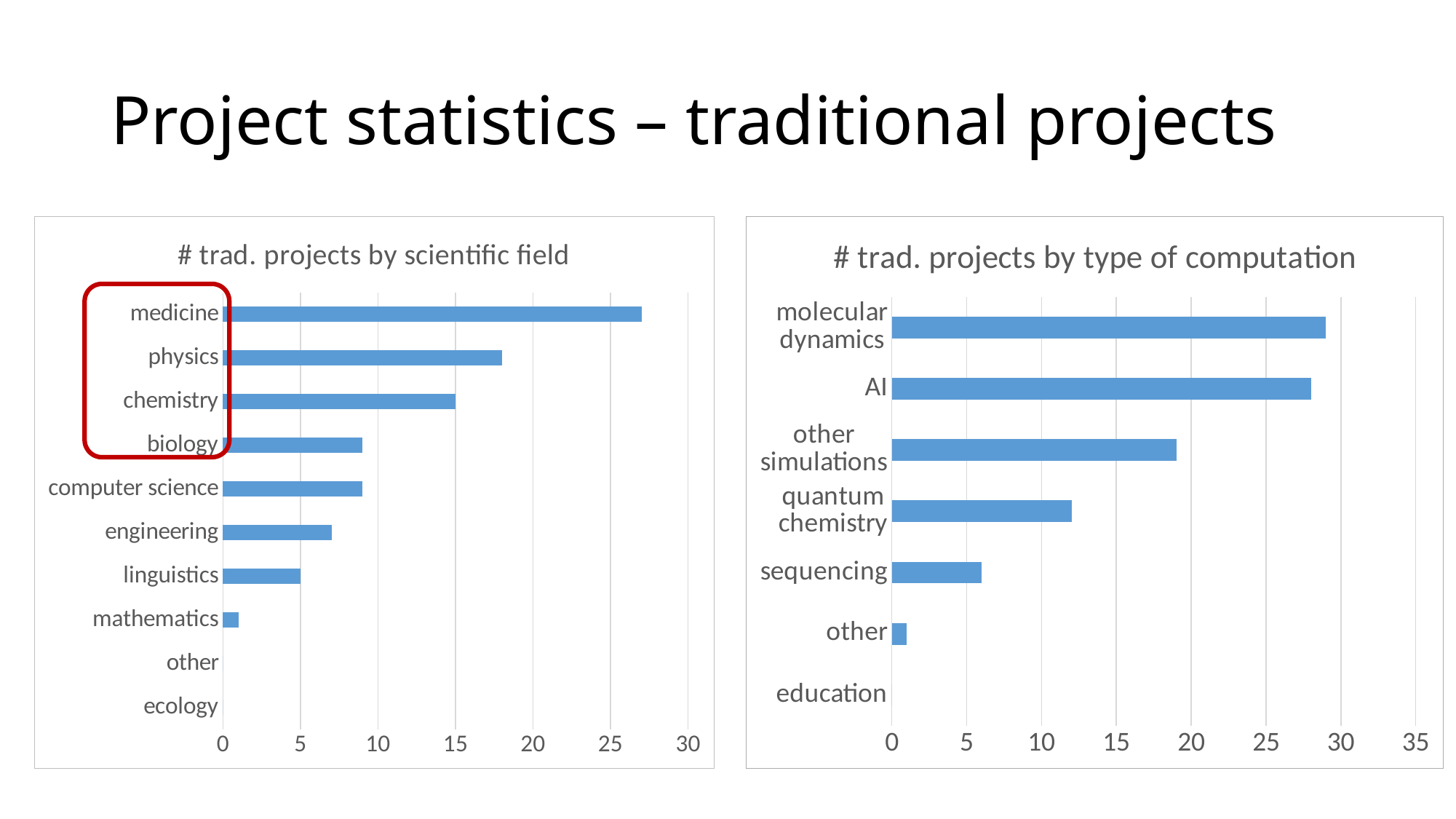
In the '# trad. projects by scientific field' chart, which is larger, physics or chemistry? physics In the '# trad. projects by scientific field' chart, what is the value for chemistry? 15 In the '# trad. projects by scientific field' chart, what is the value for linguistics? 5 In the '# trad. projects by scientific field' chart, is the value for biology greater or less than 10? less In the '# trad. projects by type of computation' chart, is the value for molecular dynamics greater or less than 25? greater How many types of computation are listed in the '# trad. projects by type of computation' chart? 7 What kind of chart is '# trad. projects by scientific field'? bar chart In the '# trad. projects by scientific field' chart, which scientific field has the highest number of projects? medicine In the '# trad. projects by scientific field' chart, is the value for medicine greater or less than 25? greater In the '# trad. projects by type of computation' chart, which type of computation has the lowest number of projects? education How many scientific fields are listed in the '# trad. projects by scientific field' chart? 10 In the '# trad. projects by type of computation' chart, which is larger, quantum chemistry or sequencing? quantum chemistry